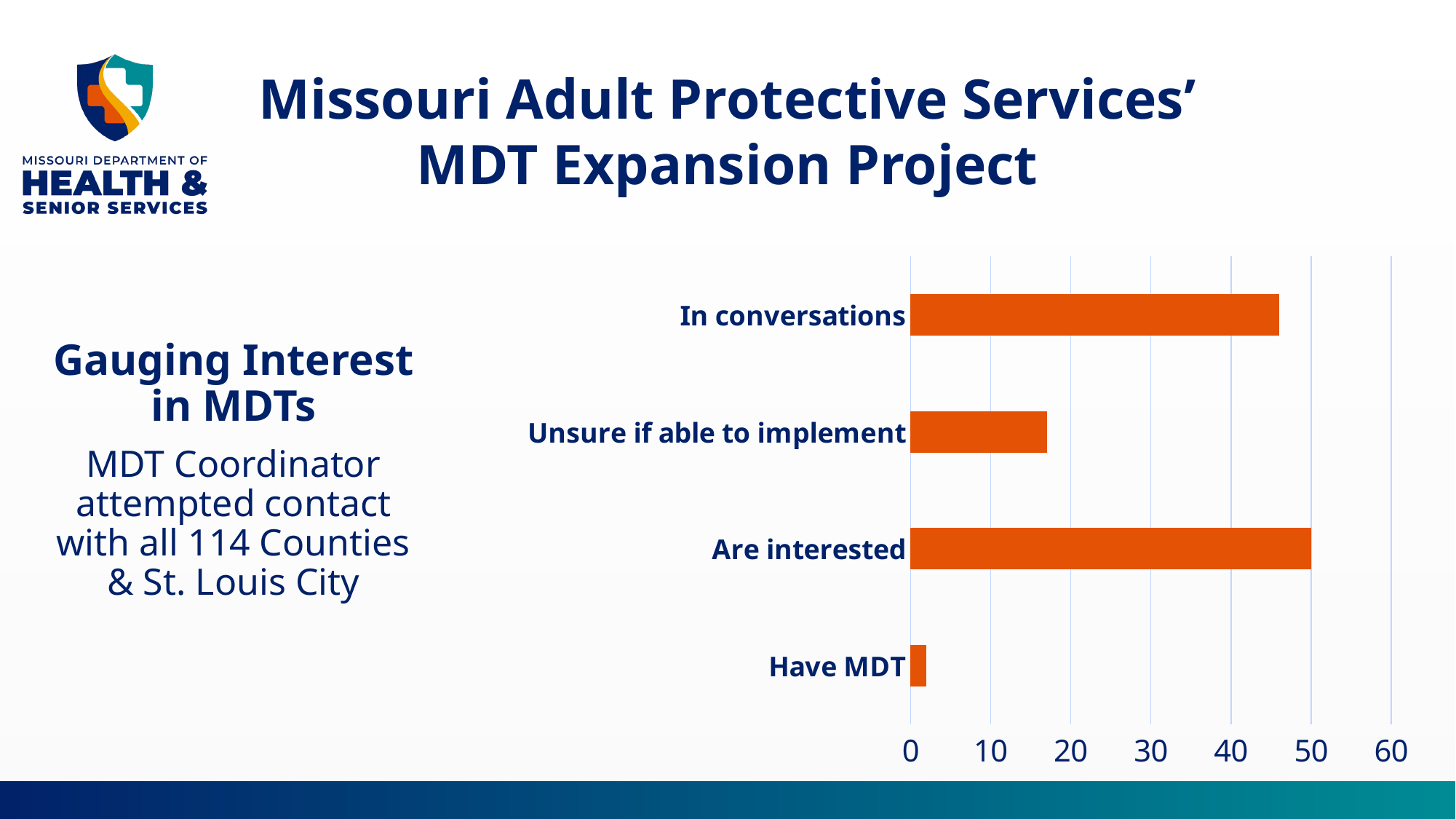
Is the value for Have MDT greater or less than 10? less Is the value for Unsure if able to implement greater or less than 20? less How many categories does the bar chart show? 4 Is the value for Unsure if able to implement greater or less than 10? greater What kind of chart is shown on the slide? bar chart What is the value for Are interested? 50 Which category has the highest value in the bar chart? Are interested What is the highest value shown on the x axis of the bar chart? 60 Which is larger, the value for In conversations or the value for Unsure if able to implement? In conversations Which category has the lowest value in the bar chart? Have MDT